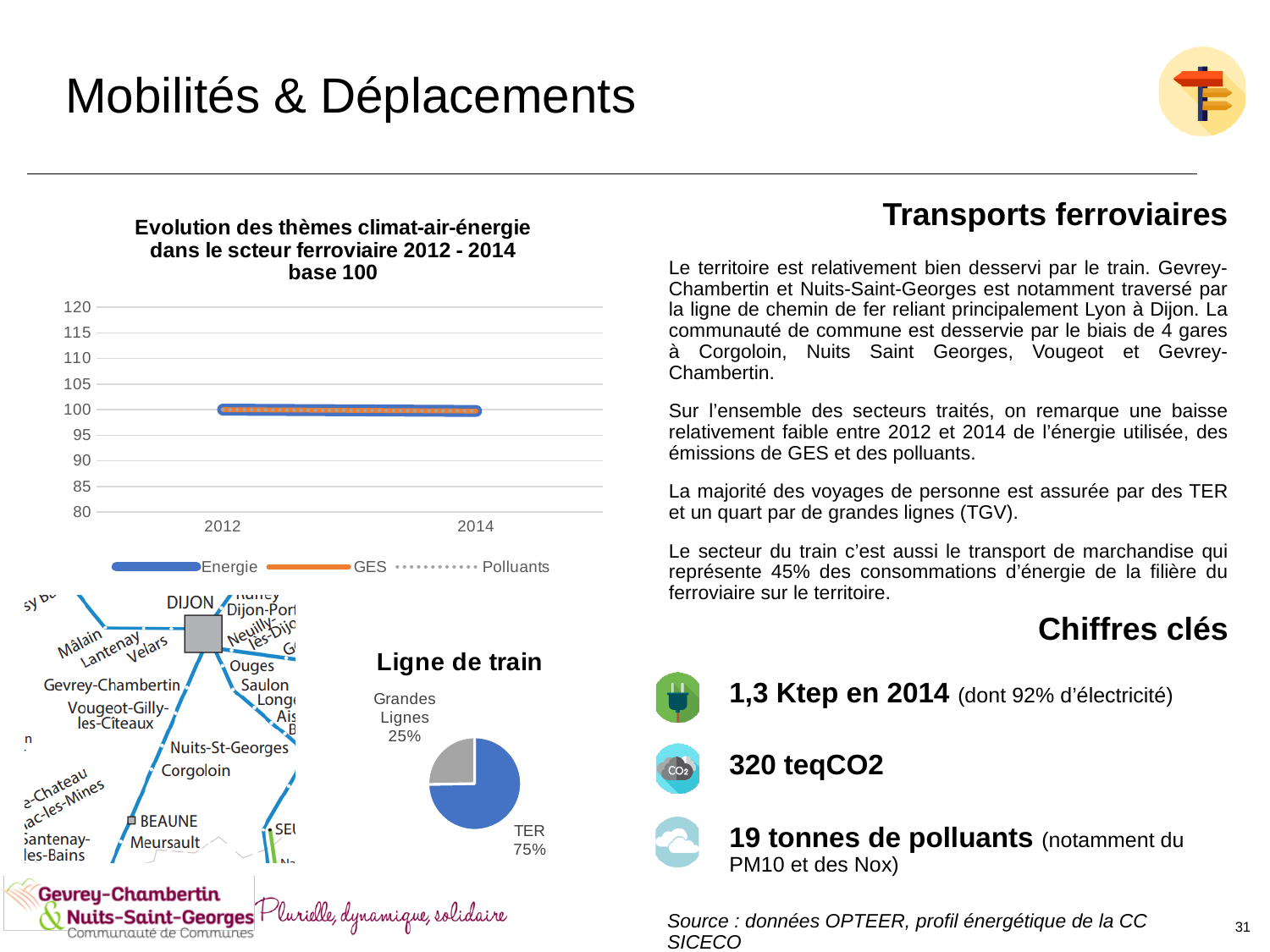
In the 'Evolution des thèmes climat-air-énergie' line chart, is the value for Energie in 2014 greater or less than 110? less In the 'Ligne de train' pie chart, what share is TER? 75% In the 'Ligne de train' pie chart, which slice is the smallest? Grandes Lignes In the 'Ligne de train' pie chart, by how many percentage points does TER exceed Grandes Lignes? 50 percentage points How many series does the legend of the 'Evolution des thèmes climat-air-énergie' line chart list? 3 How many years are shown on the x axis of the 'Evolution des thèmes climat-air-énergie' line chart? 2 In the 'Ligne de train' pie chart, which slice is the largest? TER How many slices does the 'Ligne de train' pie chart have? 2 Which series are listed in the legend of the 'Evolution des thèmes climat-air-énergie' line chart? Energie, GES, Polluants In the 'Ligne de train' pie chart, what share is Grandes Lignes? 25% What kind of chart is the 'Ligne de train' chart? pie chart What kind of chart is the 'Evolution des thèmes climat-air-énergie dans le scteur ferroviaire 2012 - 2014 base 100' chart? line chart